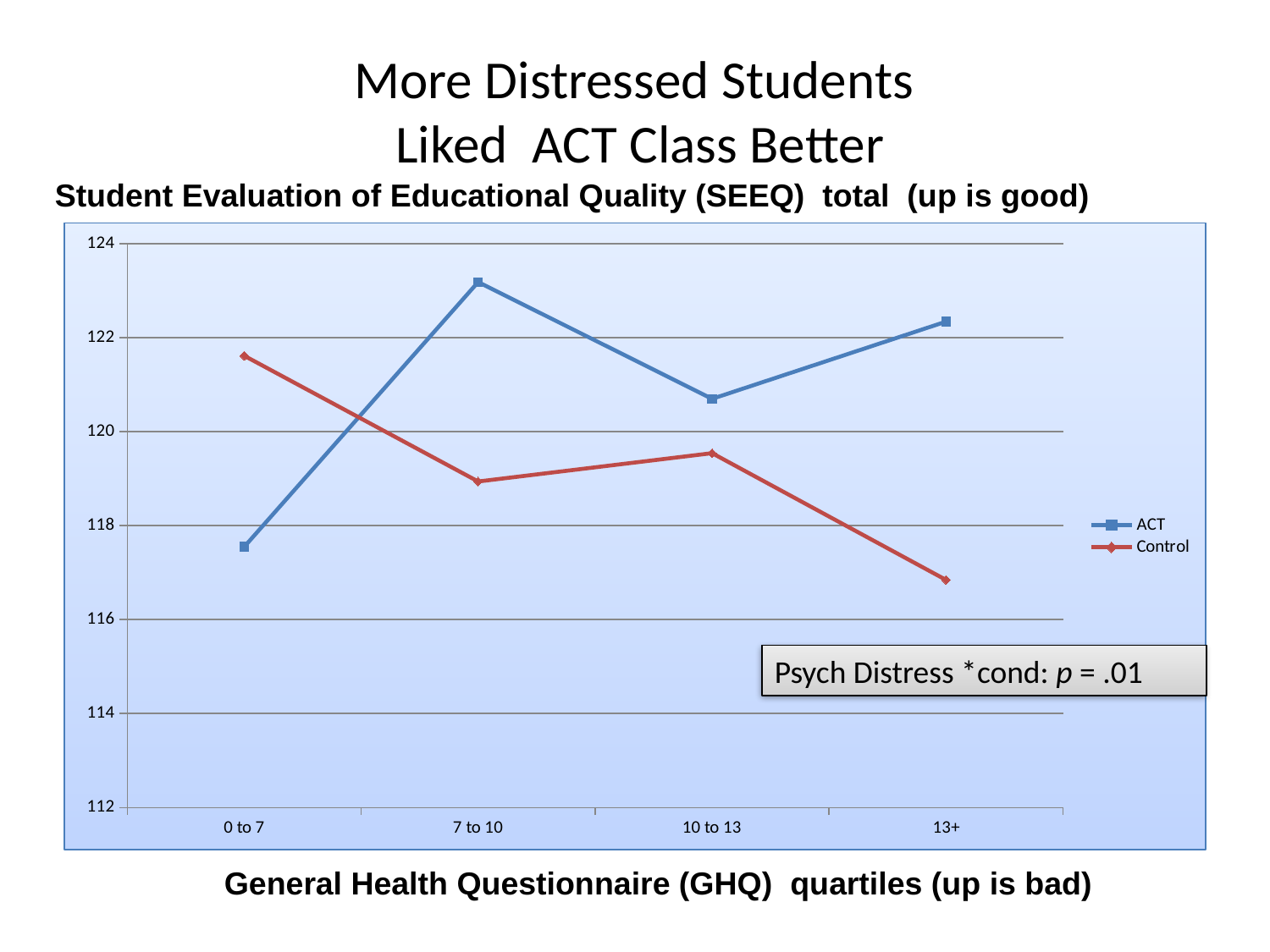
For which GHQ quartile is the Control series highest? 0 to 7 Is the value for Control at the 13+ quartile greater or less than 118? less Is the value for ACT at the 7 to 10 quartile greater or less than 122? greater How many GHQ quartile categories are shown on the x axis? 4 At the 13+ quartile, which series has the higher value, ACT or Control? ACT At the 0 to 7 quartile, which series has the higher value, ACT or Control? Control For which GHQ quartile is the Control series lowest? 13+ For which GHQ quartile is the ACT series lowest? 0 to 7 What kind of chart is shown on the slide? line chart For which GHQ quartile is the ACT series highest? 7 to 10 Which series are listed in the legend? ACT and Control How many series does the legend list? 2